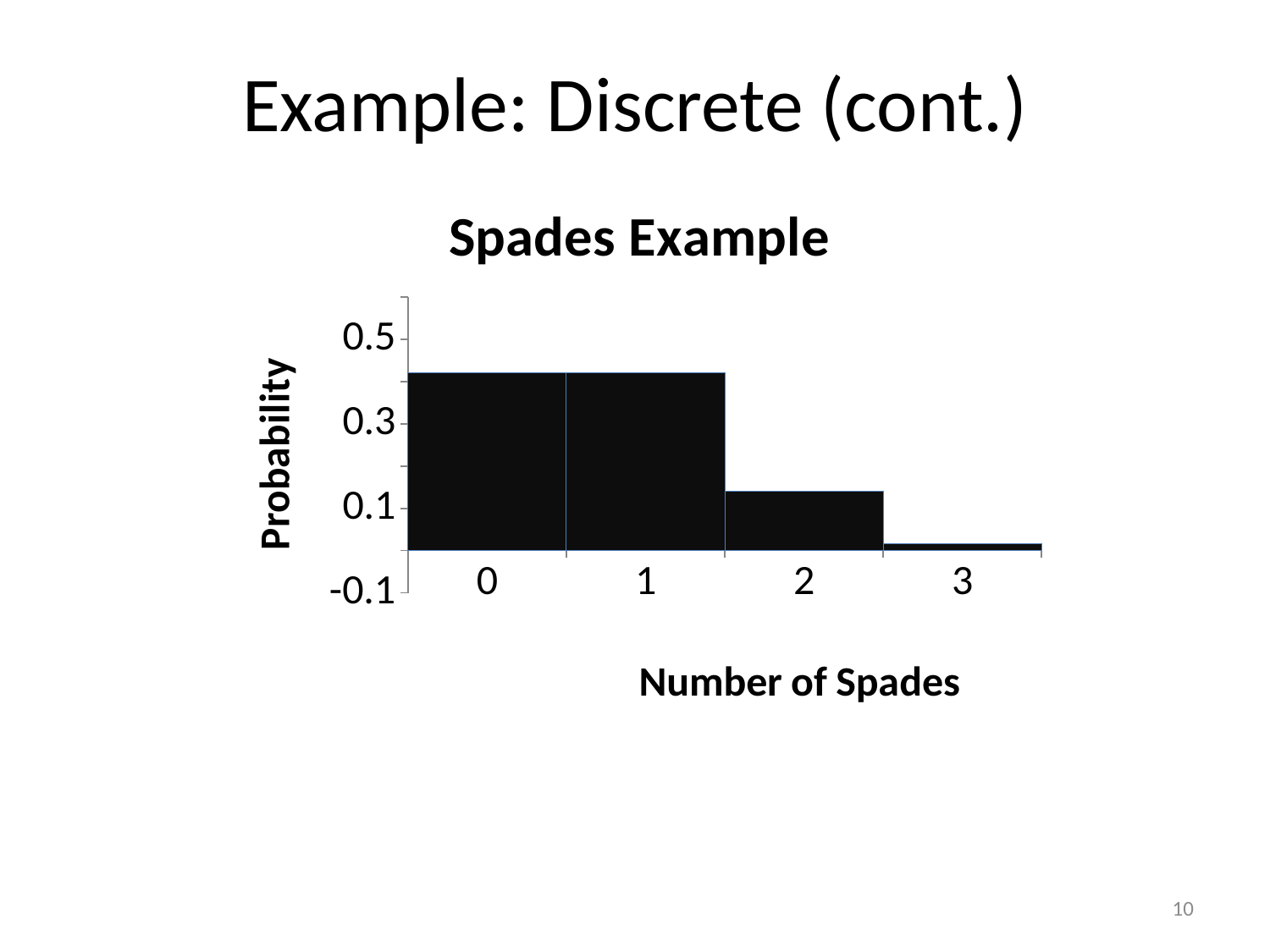
Is the probability for 2 spades greater or less than 0.3? less Is the probability for 3 spades greater or less than 0.1? less Is the probability for 1 spade greater or less than 0.5? less How many categories are shown on the x axis? 4 Do the probabilities generally rise or fall as the number of spades increases? fall What is the label of the x axis? Number of Spades Which has a higher probability, 2 spades or 3 spades? 2 spades What is the title of the chart? Spades Example Which has a higher probability, 1 spade or 2 spades? 1 spade What type of chart is shown on the slide? bar chart Which number of spades has the lowest probability? 3